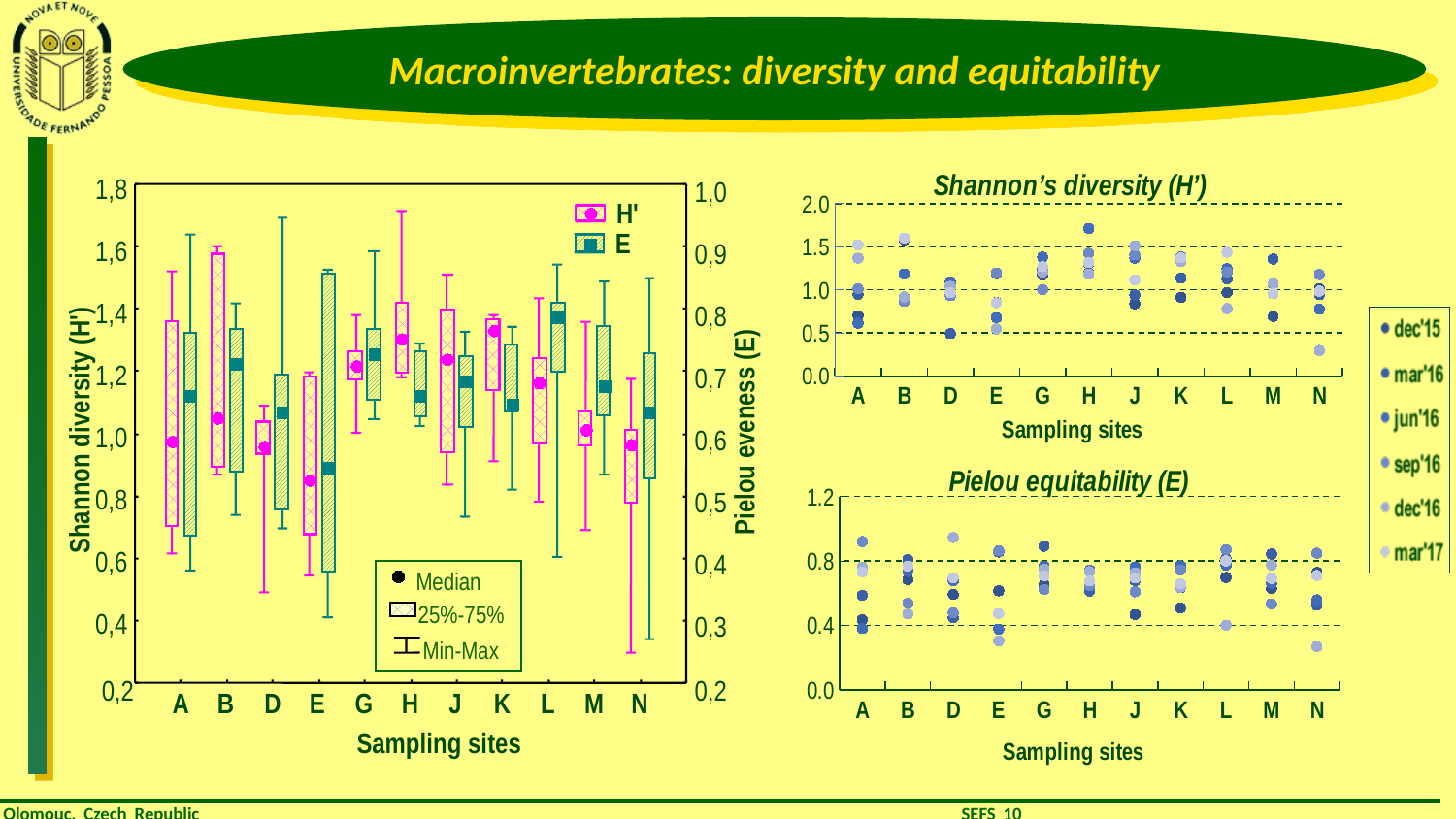
In the left chart, what is the label of the left y axis? Shannon diversity (H') What kind of chart is the left chart? box plot In the Shannon's diversity (H') chart, is the highest value at site H greater or less than 1.5? greater In the left chart, which site has the larger H' median, K or E? K In the left chart, is the H' median for site E greater or less than 1,0? less In the left chart, how many sampling sites are shown on the x axis? 11 In the left chart, what is the label of the right y axis? Pielou eveness (E) In the left chart, how many series does the legend list? 2 In the left chart, is the H' median for site K greater or less than 1,2? greater In the left chart, which site has the lowest H' median? E In the Shannon's diversity (H') chart, how many sampling dates does the legend list? 6